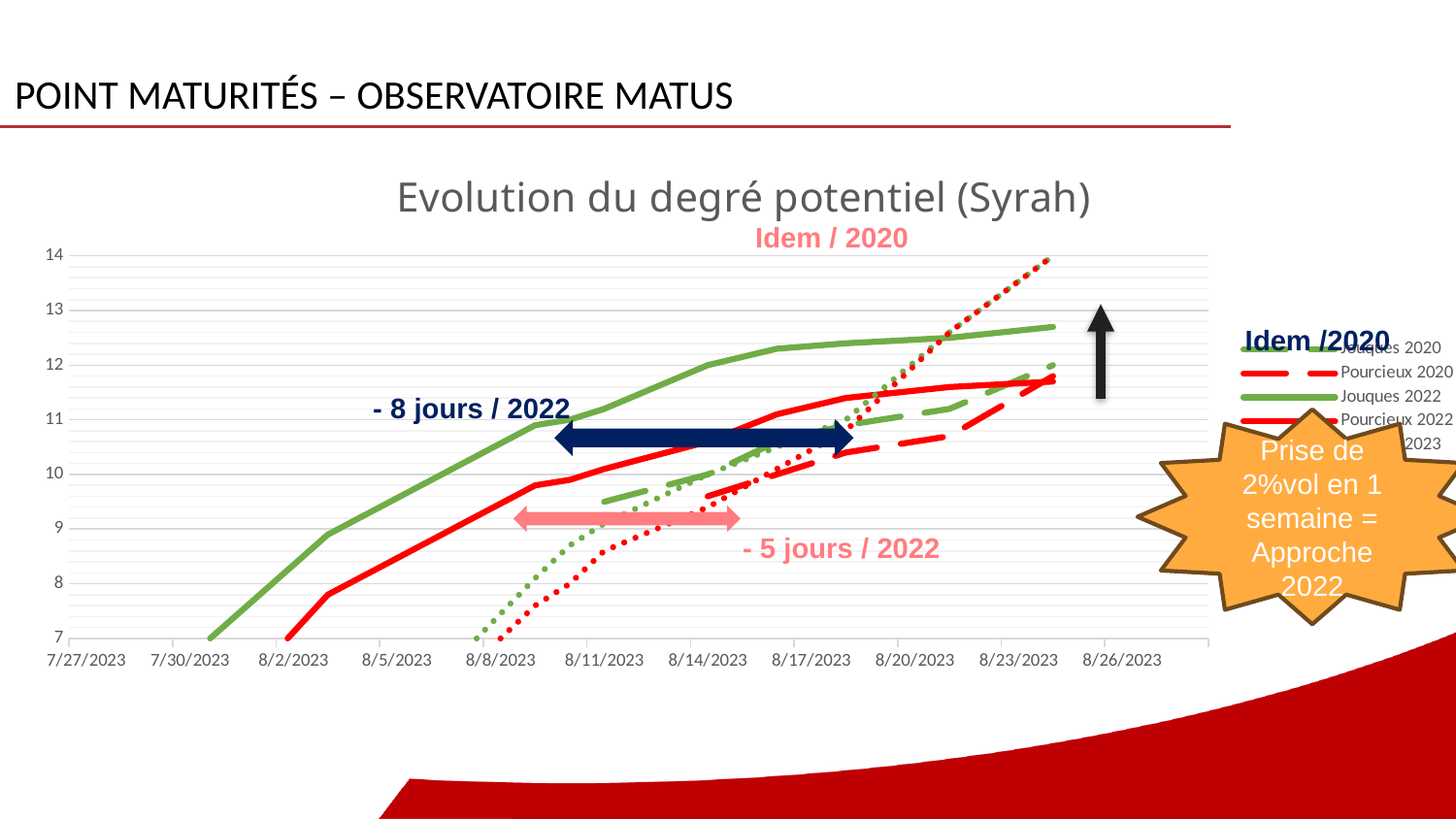
How many date labels are shown on the x axis? 11 Does the Jouques 2022 line rise or fall from left to right along the x axis? Rises What is the highest value shown on the y axis? 14 Is the value for Pourcieux 2022 on 8/14/2023 greater or less than 10? greater Is the value for Pourcieux 2022 on 8/23/2023 greater or less than 12? less What kind of chart is shown on the slide? Line chart Does the Pourcieux 2022 line rise or fall from left to right along the x axis? Rises What is the title of the chart? Evolution du degré potentiel (Syrah) Is the value for Jouques 2022 on 8/14/2023 greater or less than 11? greater On 8/23/2023, which is higher: Jouques 2022 or Pourcieux 2022? Jouques 2022